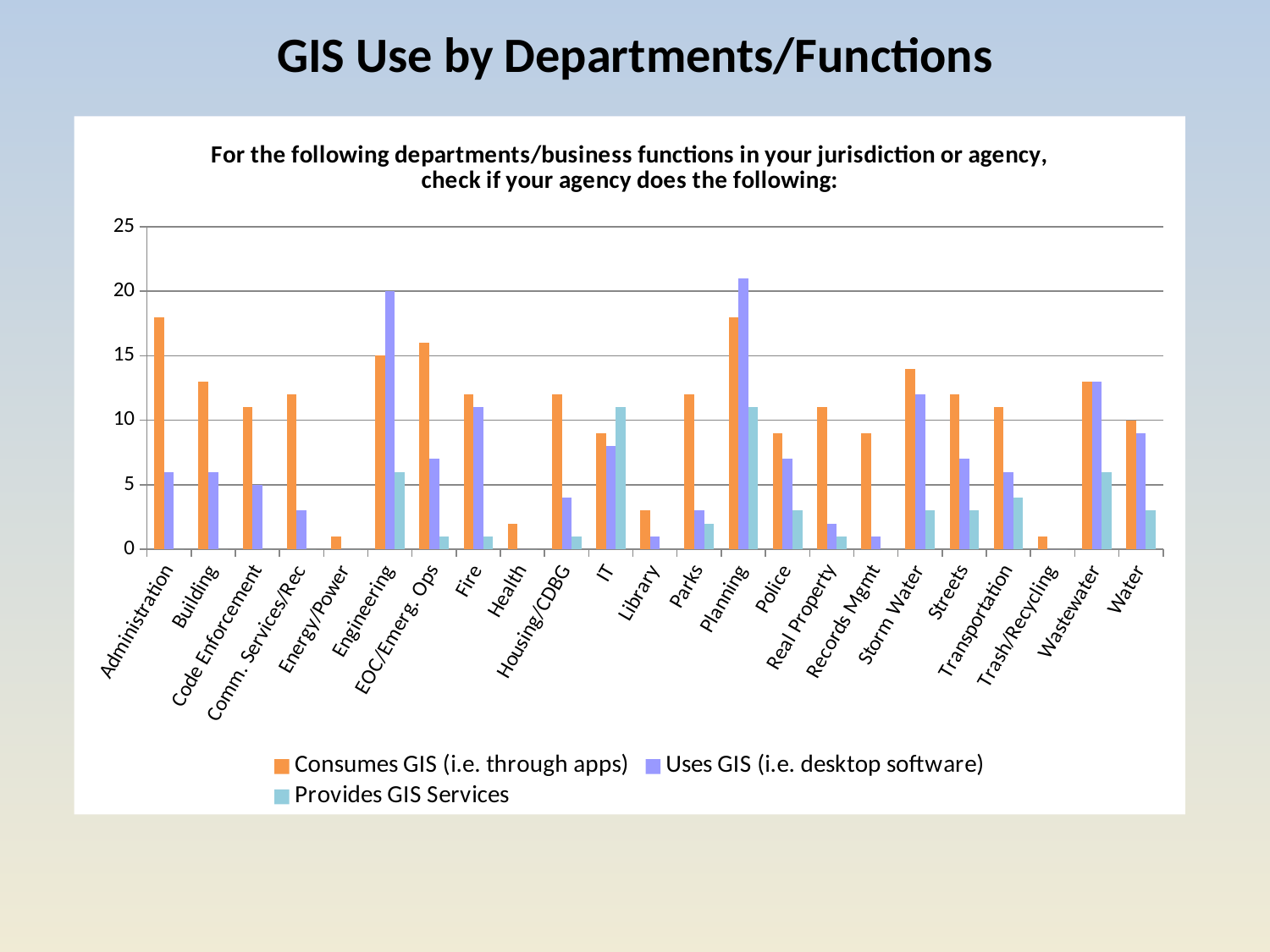
For Administration, which is larger: Consumes GIS or Uses GIS? Consumes GIS What kind of chart is shown on the slide? Bar chart For IT, which is larger: Provides GIS Services or Consumes GIS? Provides GIS Services For Engineering, which is larger: Uses GIS or Consumes GIS? Uses GIS How many departments/functions are shown along the x axis? 23 Which series is shown in light blue in the legend? Provides GIS Services Is the Uses GIS value for Storm Water greater or less than 10? greater Is the Consumes GIS value for Administration greater or less than 15? greater Is the Consumes GIS value for Library greater or less than 5? less Which series is shown in orange in the legend? Consumes GIS (i.e. through apps) How many series does the legend list? 3